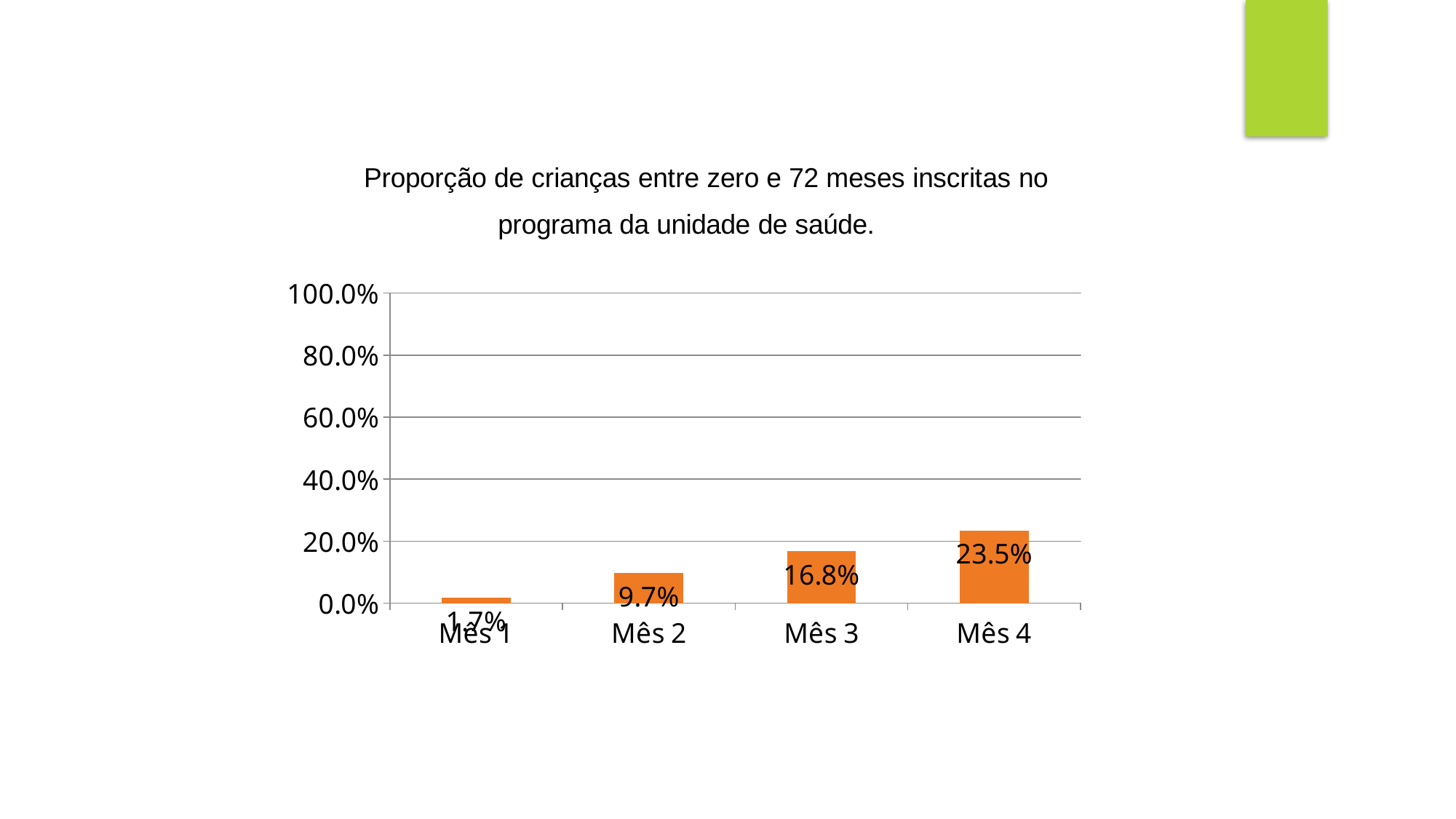
Which is larger, the value for Mês 2 or the value for Mês 3? Mês 3 What is the difference between the values for Mês 2 and Mês 1? 8.0% What is the value for Mês 4? 23.5% How many months are shown on the x axis? 4 Which month has the highest value? Mês 4 What kind of chart is this? bar chart What is the value for Mês 2? 9.7% What is the difference between the values for Mês 4 and Mês 3? 6.7% What is the value for Mês 1? 1.7% Which month has the lowest value? Mês 1 Is the value for Mês 4 greater or less than 20.0%? greater What is the value for Mês 3? 16.8%